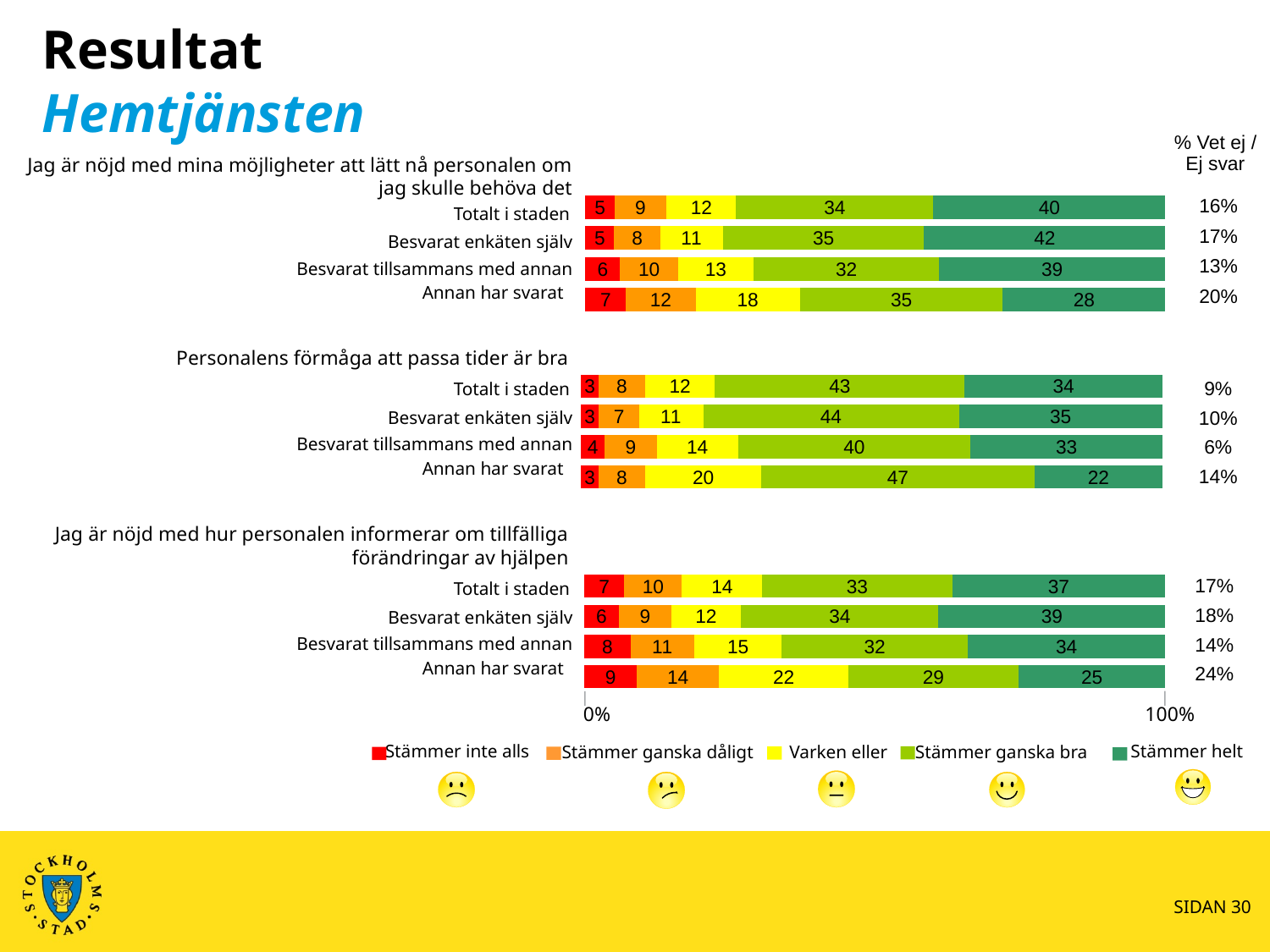
For the statement 'Jag är nöjd med hur personalen informerar om tillfälliga förändringar av hjälpen', what is the 'Varken eller' value for 'Annan har svarat'? 22 What is the '% Vet ej / Ej svar' value for 'Annan har svarat' under 'Jag är nöjd med hur personalen informerar om tillfälliga förändringar av hjälpen'? 24% For the statement 'Personalens förmåga att passa tider är bra', what is the 'Stämmer ganska bra' value for 'Totalt i staden'? 43 For the statement 'Jag är nöjd med mina möjligheter att lätt nå personalen om jag skulle behöva det', what is the 'Stämmer helt' value for 'Besvarat enkäten själv'? 42 How many series does the legend list? 5 How many rows (bars) are shown for the statement 'Jag är nöjd med hur personalen informerar om tillfälliga förändringar av hjälpen'? 4 For the statement 'Personalens förmåga att passa tider är bra', which row has the highest 'Stämmer ganska bra' value? Annan har svarat For the statement 'Jag är nöjd med mina möjligheter att lätt nå personalen om jag skulle behöva det', which row has the lowest 'Stämmer helt' value? Annan har svarat Which legend entry is shown in dark green? Stämmer helt For the statement 'Jag är nöjd med hur personalen informerar om tillfälliga förändringar av hjälpen', what is the difference between the 'Stämmer helt' values for 'Besvarat enkäten själv' and 'Annan har svarat'? 14 For the statement 'Personalens förmåga att passa tider är bra', which is larger: the 'Stämmer helt' value for 'Besvarat enkäten själv' or for 'Annan har svarat'? Besvarat enkäten själv What type of chart is shown on the slide? Stacked bar chart